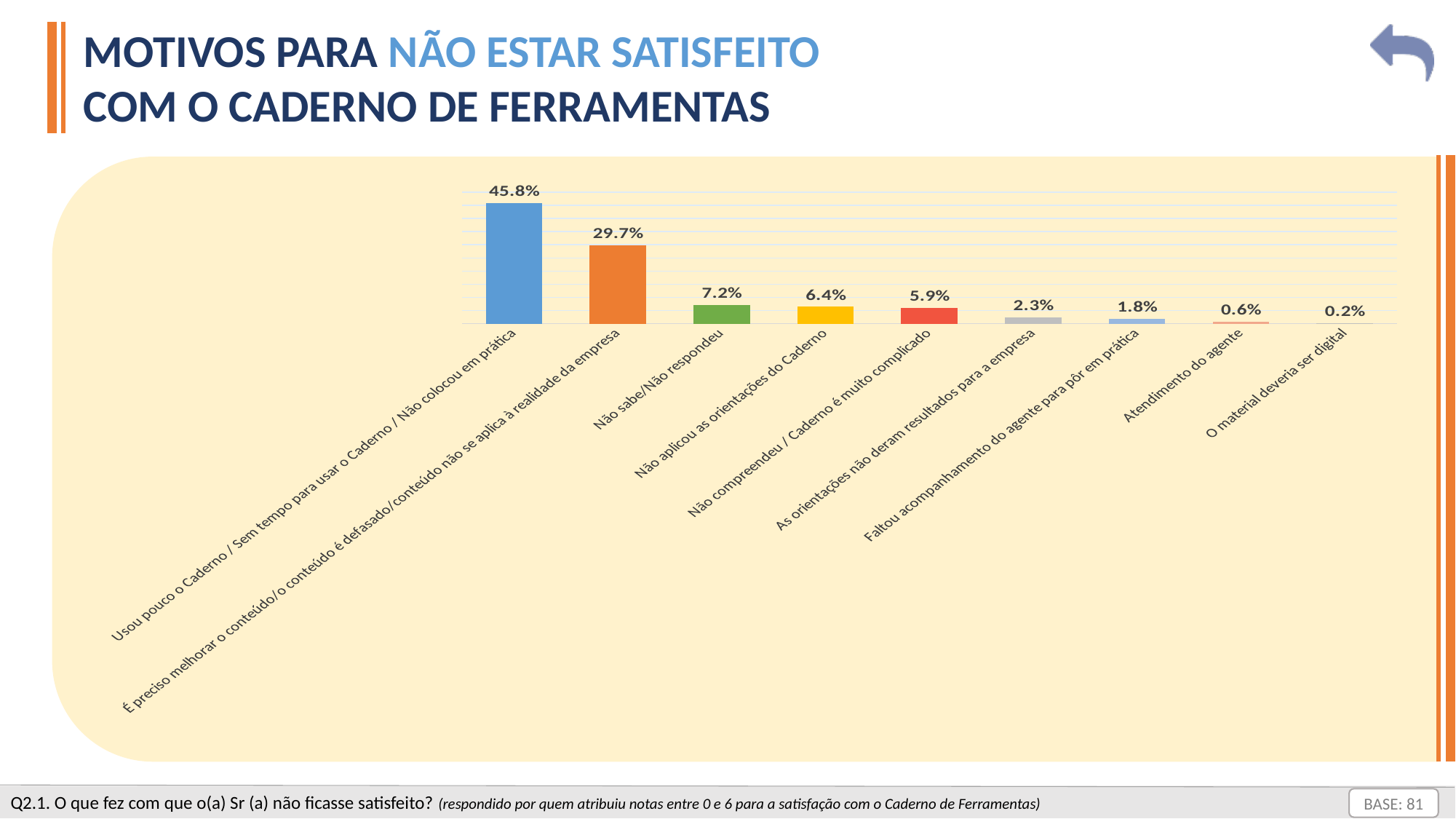
Which category has the highest value? Usou pouco o Caderno / Sem tempo para usar o Caderno / Não colocou em prática Which category has the lowest value? O material deveria ser digital Do the values rise or fall from left to right along the x axis? Fall What is the value for "O material deveria ser digital"? 0.2% What is the value for "Não sabe/Não respondeu"? 7.2% What is the value for "Faltou acompanhamento do agente para pôr em prática"? 1.8% What is the difference between the values for "Usou pouco o Caderno / Sem tempo para usar o Caderno / Não colocou em prática" and "É preciso melhorar o conteúdo/o conteúdo é defasado/conteúdo não se aplica à realidade da empresa"? 16.1% Which is larger: the value for "Não aplicou as orientações do Caderno" or for "Não compreendeu / Caderno é muito complicado"? Não aplicou as orientações do Caderno What is the value for "Usou pouco o Caderno / Sem tempo para usar o Caderno / Não colocou em prática"? 45.8% What type of chart is shown on the slide? Bar chart How many categories (reasons) are plotted in the chart? 9 What colour is the bar for "É preciso melhorar o conteúdo/o conteúdo é defasado/conteúdo não se aplica à realidade da empresa"? Orange